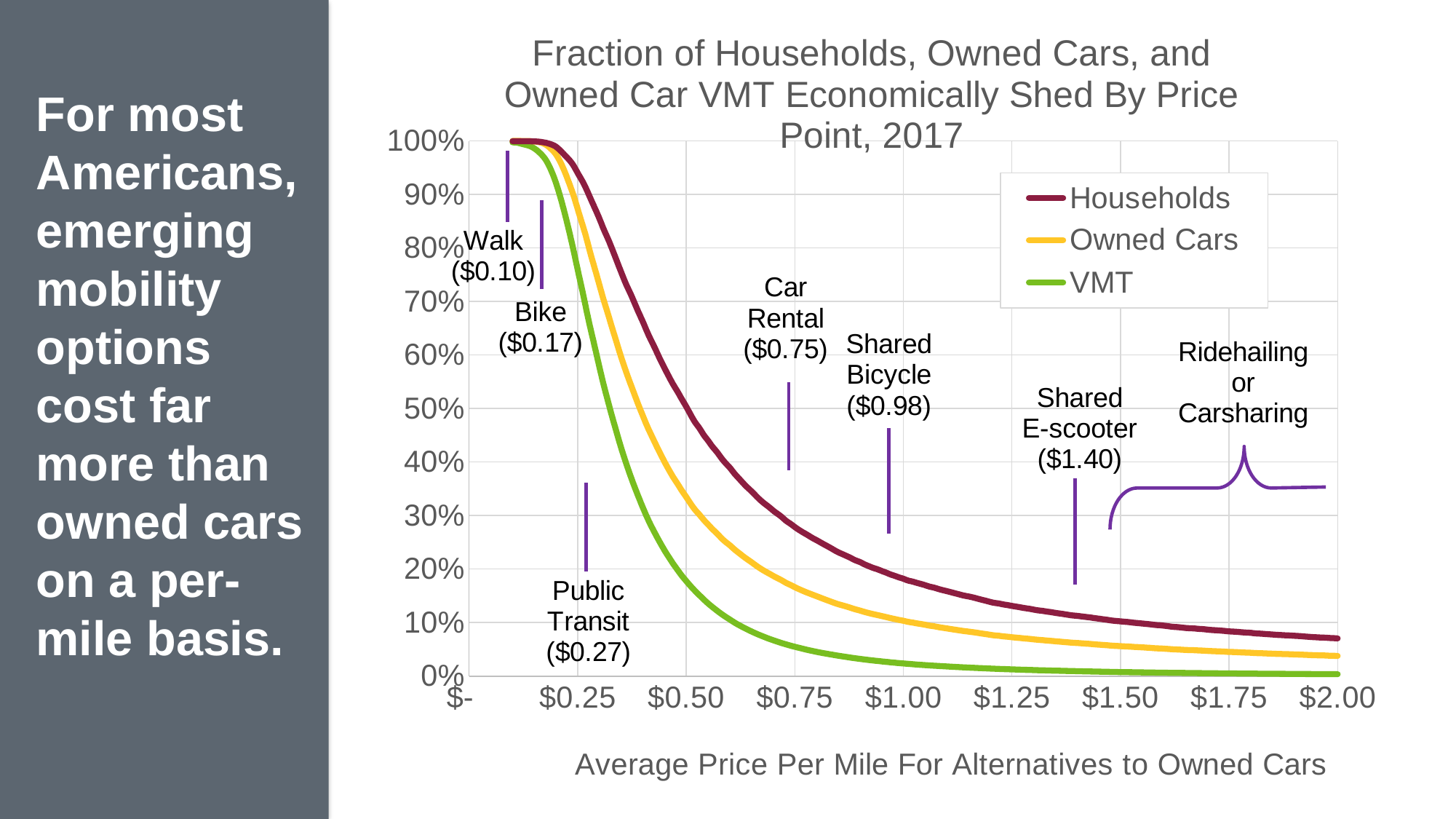
What average price per mile is annotated for Public Transit? $0.27 What is the x-axis title of the chart? Average Price Per Mile For Alternatives to Owned Cars As the average price per mile increases along the x axis, do the plotted lines rise or fall? Fall Which series are listed in the chart legend? Households, Owned Cars, VMT At $0.75 per mile, which series has the larger value, Households or VMT? Households What kind of chart is shown on the slide? Line chart What average price per mile is annotated for Shared E-scooter? $1.40 Is the Households value at $0.75 per mile greater or less than 20%? greater How many alternative mobility options are annotated on the chart? 7 Is the VMT value at $1.00 per mile greater or less than 10%? less What average price per mile is annotated for Bike? $0.17 How many series does the chart legend list? 3